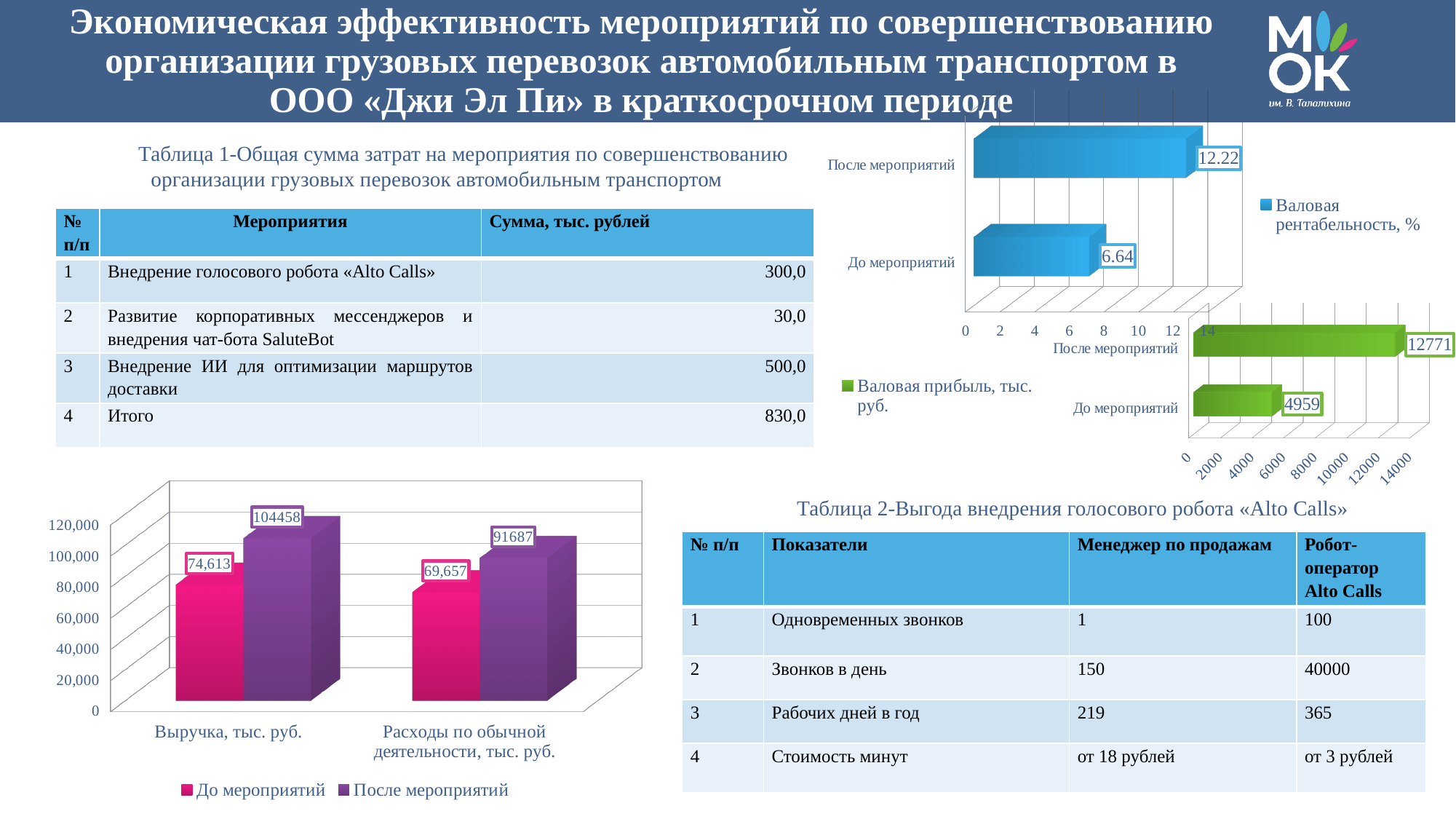
In the bar chart at the bottom left, what is the value of 'Выручка, тыс. руб.' for 'После мероприятий'? 104458 In the bar chart with the legend 'Валовая прибыль, тыс. руб.' (middle right), what is the value for 'До мероприятий'? 4959 In the bar chart with the legend 'Валовая рентабельность, %' (top right), what is the value for 'До мероприятий'? 6.64 In the bar chart with the legend 'Валовая рентабельность, %' (top right), what is the difference between the values for 'После мероприятий' and 'До мероприятий'? 5.58 In the bar chart at the bottom left, what is the value of 'Расходы по обычной деятельности, тыс. руб.' for 'До мероприятий'? 69,657 In the bar chart at the bottom left, which series is larger for 'Выручка, тыс. руб.': 'До мероприятий' or 'После мероприятий'? После мероприятий In the bar chart at the bottom left, how many series does the legend list? 2 What kind of chart is the chart at the bottom left of the slide? Bar chart In the bar chart with the legend 'Валовая прибыль, тыс. руб.' (middle right), what is the value for 'После мероприятий'? 12771 In the bar chart with the legend 'Валовая прибыль, тыс. руб.' (middle right), which category has the higher value? После мероприятий In the bar chart with the legend 'Валовая рентабельность, %' (top right), what is the value for 'После мероприятий'? 12.22 In the bar chart with the legend 'Валовая прибыль, тыс. руб.' (middle right), what is the difference between 'После мероприятий' and 'До мероприятий'? 7812